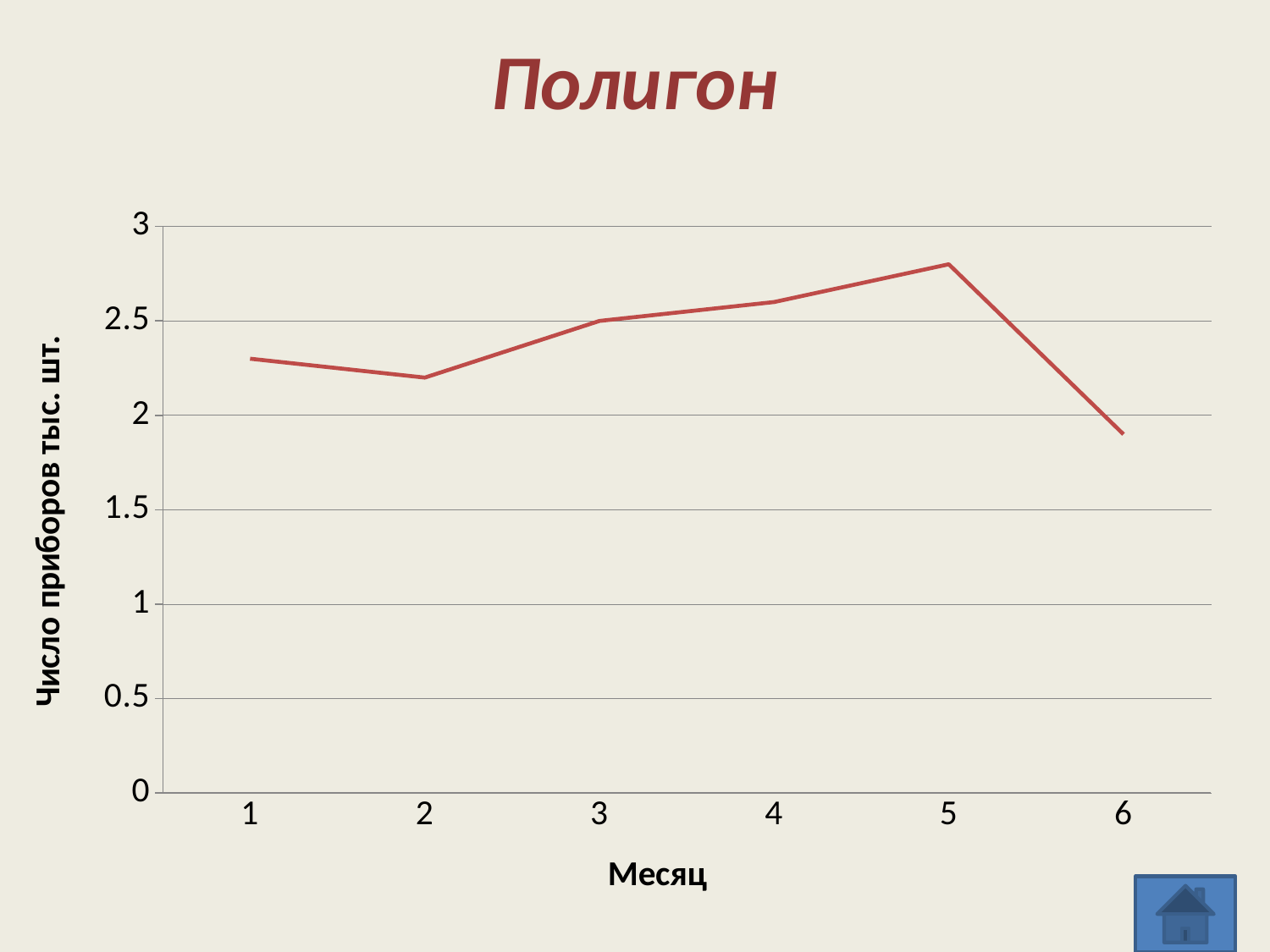
Which is larger, the value for month 4 or the value for month 2? month 4 Is the value for month 6 greater or less than 2? less What is the title of the chart on the slide? Полигон Is the value for month 2 greater or less than 2.5? less In which month is the number of devices lowest? 6 How many months (data points) are plotted on the chart? 6 What is the label of the horizontal axis? Месяц In which month is the number of devices highest? 5 Is the value for month 5 greater or less than 2.5? greater Does the value rise or fall from month 5 to month 6? fall What kind of chart is shown on the slide? line chart What is the value for month 3? 2.5